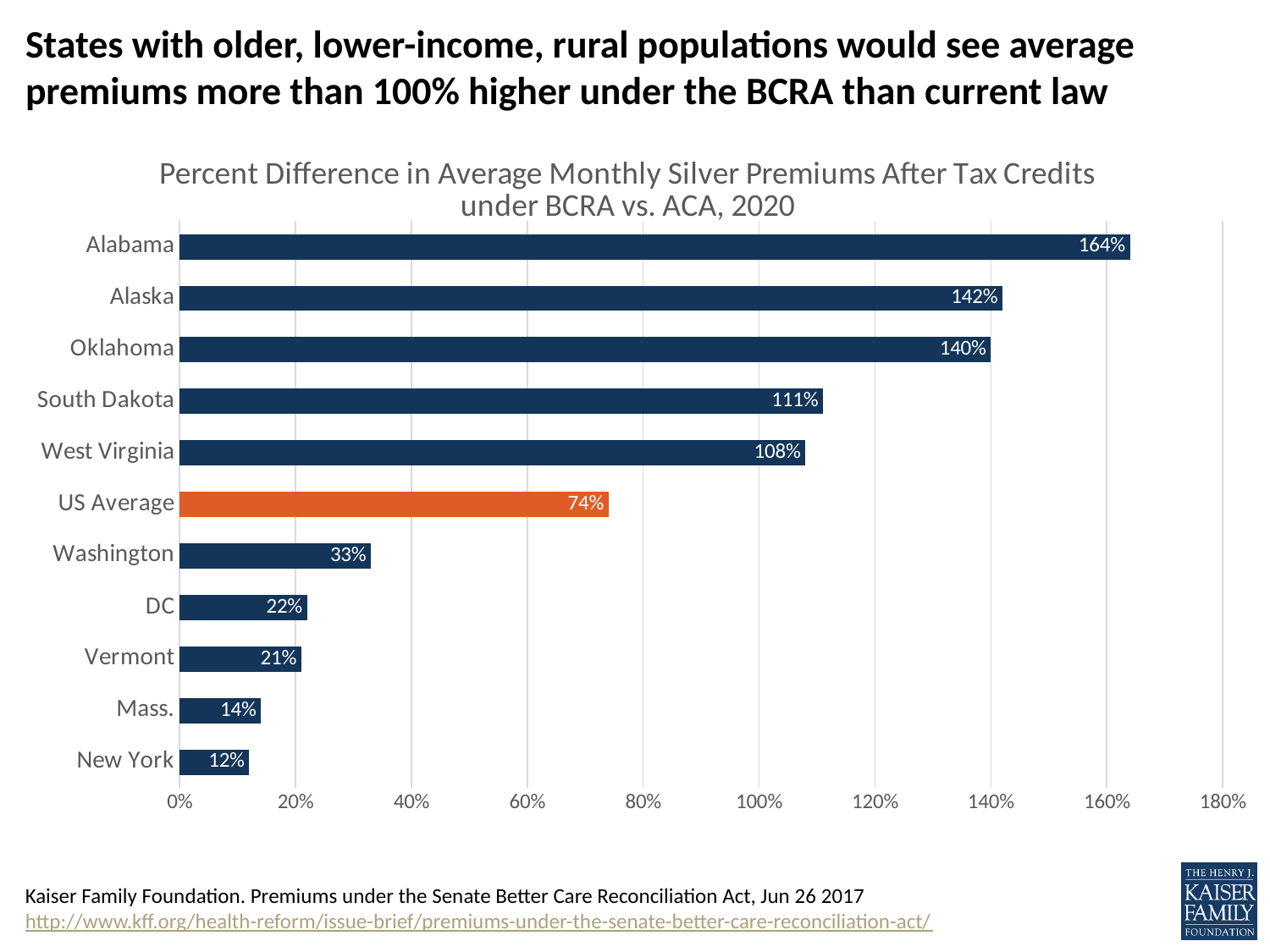
How many categories are shown on the chart? 11 What is the difference between the values for Alabama and the US Average? 90% Is the value for South Dakota greater or less than 100%? greater Which bar is shown in orange rather than dark blue? US Average What kind of chart is shown on the slide? Bar chart What is the value shown for West Virginia? 108% What is the value shown for the US Average? 74% What is the difference between the values for Alaska and Oklahoma? 2% Which has a larger value, Washington or DC? Washington What is the percent difference in average monthly silver premiums for Alabama? 164% Which category has the lowest value on the chart? New York Which category has the highest value on the chart? Alabama